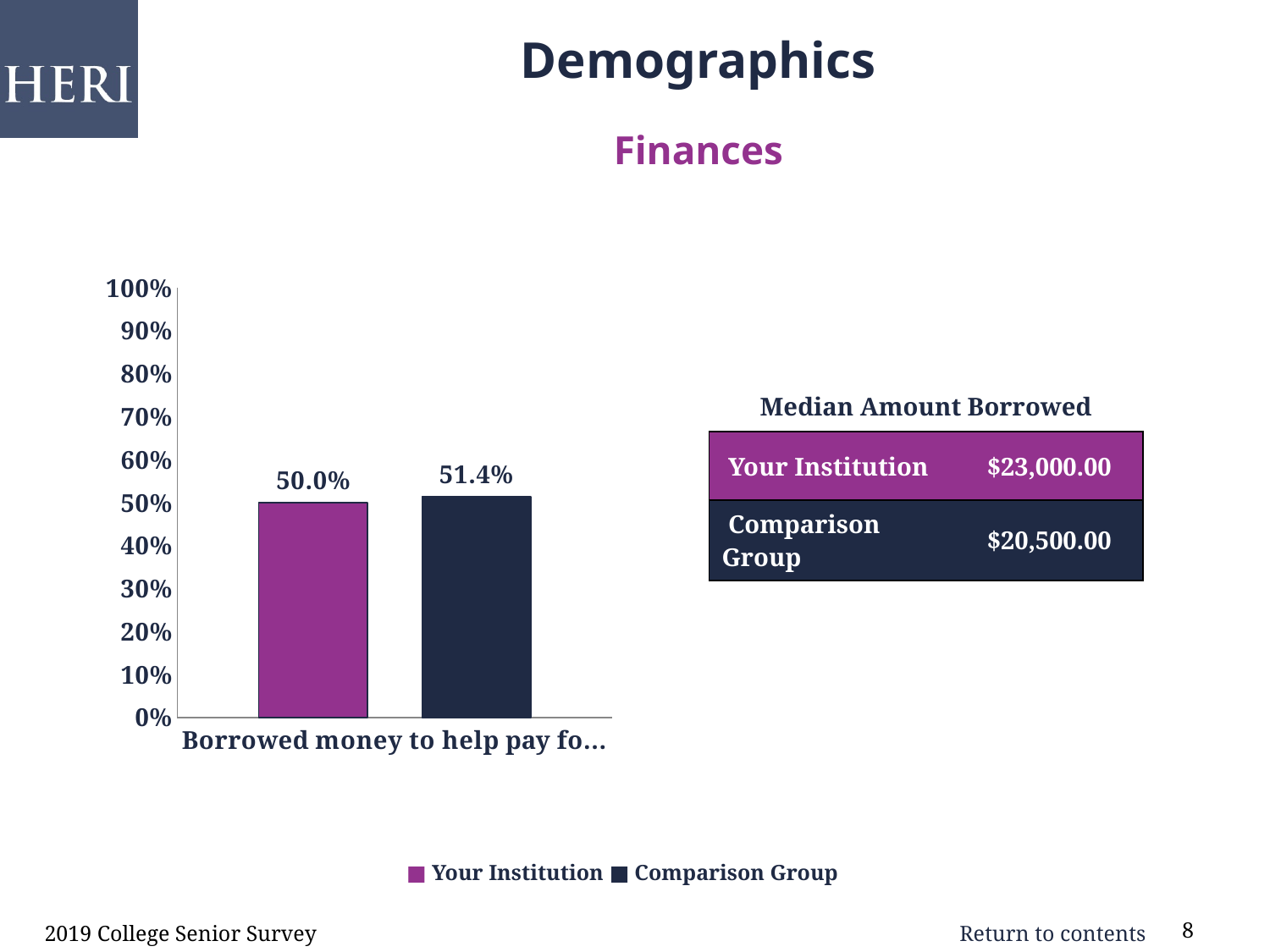
What is the value for Your Institution in the bar chart? 50.0% Is the value for Comparison Group in the bar chart greater or less than 60%? less What is the maximum value shown on the y axis of the bar chart? 100% What is the value for Comparison Group in the bar chart? 51.4% What is the difference between the Comparison Group value and the Your Institution value in the bar chart? 1.4% How many bars are plotted in the bar chart? 2 Is the value for Your Institution in the bar chart greater or less than 40%? greater What kind of chart is shown on the slide? Bar chart Which series has the lowest value in the bar chart? Your Institution How many series does the legend of the bar chart list? 2 Which series has the higher value in the bar chart, Your Institution or Comparison Group? Comparison Group What colour is the Your Institution bar in the chart? Purple